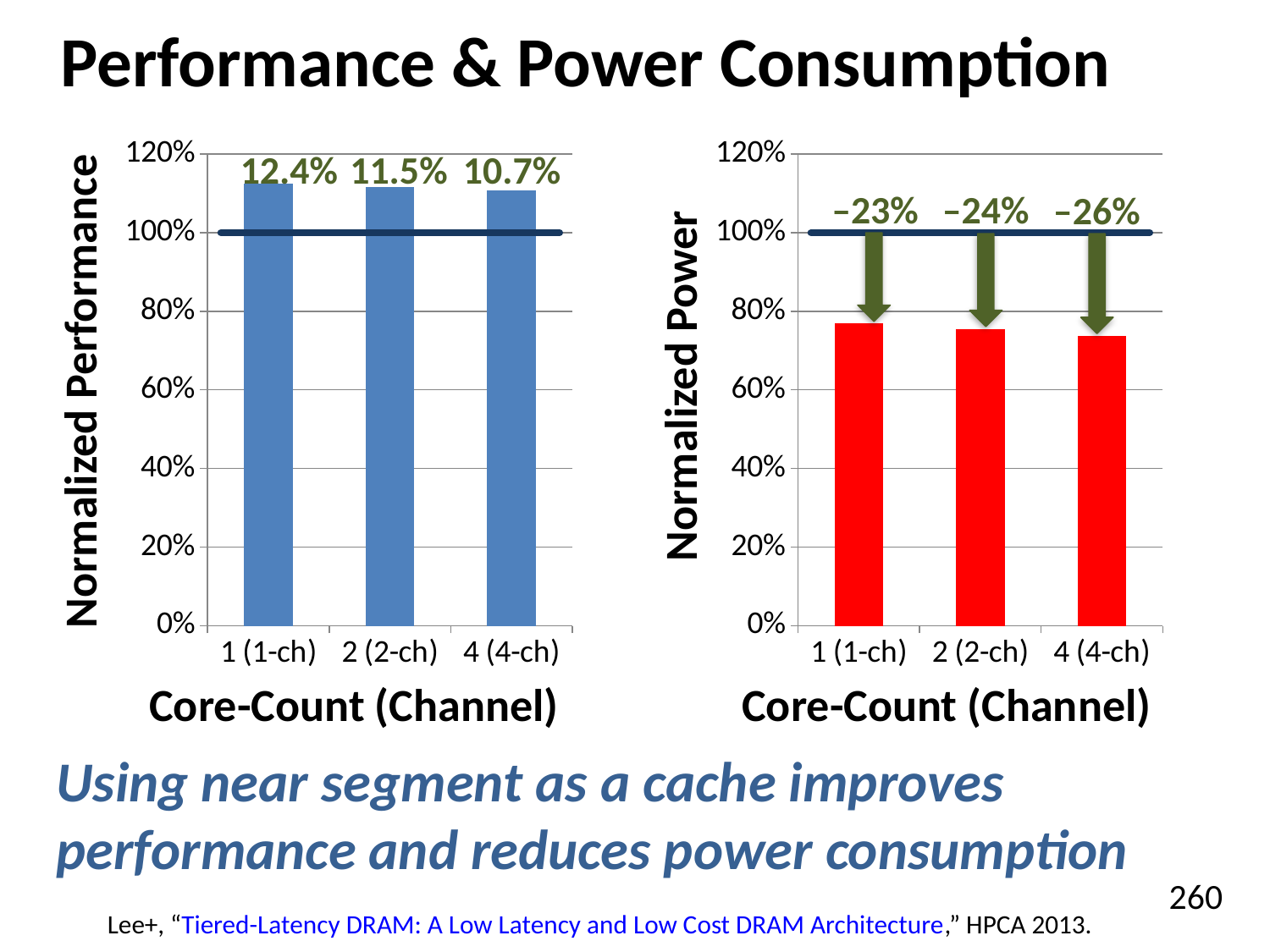
In the left chart (Normalized Performance), which core-count configuration has the smallest labeled performance improvement? 4 (4-ch) In the right chart (Normalized Power), what power reduction is labeled above the bar for 2 (2-ch)? –24% In the left chart (Normalized Performance), do the bar heights rise or fall as the core count increases from 1 to 4? fall How many core-count categories are shown on the x axis of the right chart (Normalized Power)? 3 In the left chart (Normalized Performance), what performance improvement is labeled above the bar for 1 (1-ch)? 12.4% In the left chart (Normalized Performance), which core-count configuration has the largest labeled performance improvement? 1 (1-ch) In the left chart (Normalized Performance), is the normalized performance bar for 2 (2-ch) greater or less than 100%? greater What kind of chart is the left chart (Normalized Performance)? bar chart In the right chart (Normalized Power), is the normalized power bar for 1 (1-ch) greater or less than 80%? less In the left chart (Normalized Performance), what performance improvement is labeled above the bar for 4 (4-ch)? 10.7% In the right chart (Normalized Power), what power reduction is labeled above the bar for 4 (4-ch)? –26% In the left chart (Normalized Performance), what is the difference between the labeled improvements for 1 (1-ch) and 4 (4-ch)? 1.7%